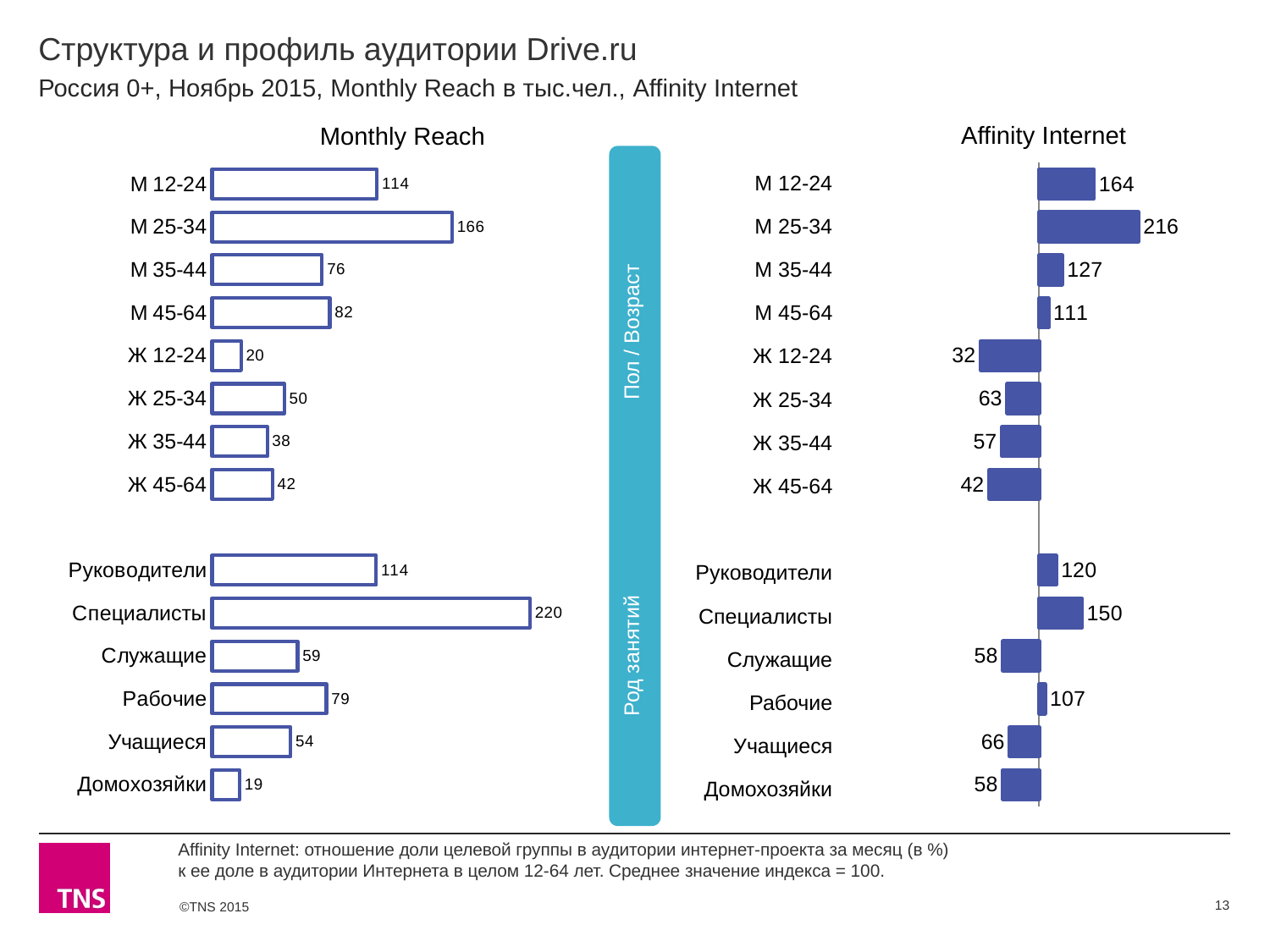
In the Affinity Internet chart, which is larger: М 12-24 or Руководители? М 12-24 In the Affinity Internet chart, which category has the lowest value? Ж 12-24 In the Monthly Reach chart, what is the difference between М 25-34 and М 12-24? 52 In the Monthly Reach chart, what is the value for Домохозяйки? 19 In the Monthly Reach chart, which is larger: Рабочие or Служащие? Рабочие How many categories are plotted in the Monthly Reach chart? 14 What is the title of the chart on the right side of the slide? Affinity Internet In the Affinity Internet chart, what is the value for Специалисты? 150 In the Monthly Reach chart, which category has the highest value? Специалисты What type of chart is the Affinity Internet chart? bar chart In the Affinity Internet chart, what is the difference between М 25-34 and Ж 12-24? 184 In the Monthly Reach chart, what is the value for М 25-34? 166